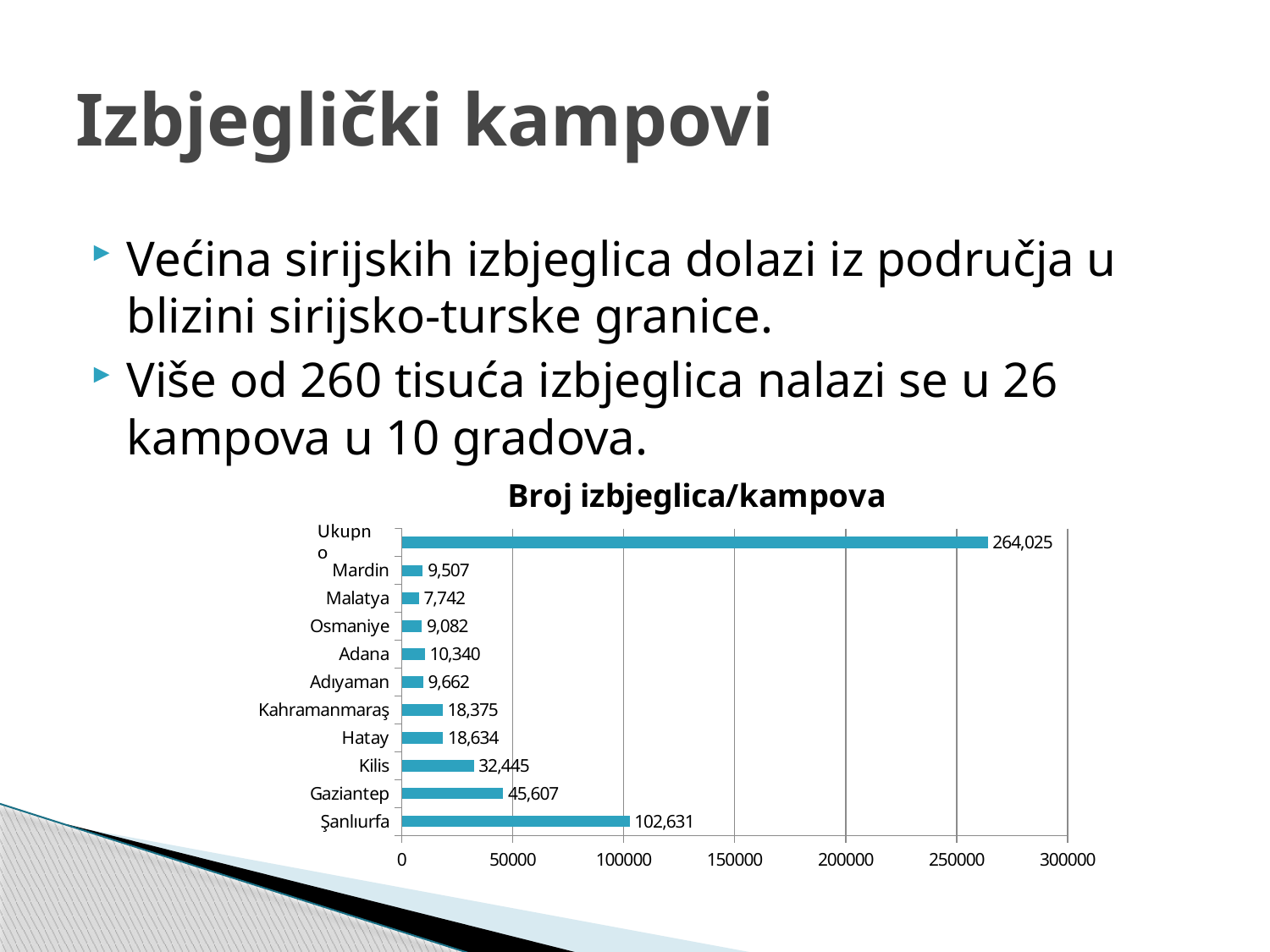
What is the value for Ukupno? 264,025 What is the title of the chart? Broj izbjeglica/kampova Which category has the lowest value? Malatya What is the difference between the values for Şanlıurfa and Gaziantep? 57,024 Excluding the Ukupno total bar, which city has the highest value? Şanlıurfa What is the value for Şanlıurfa? 102,631 What is the value for Gaziantep? 45,607 What kind of chart is shown on the slide? bar chart Which is larger, the value for Adana or the value for Osmaniye? Adana How many categories are shown on the chart? 11 Is the value for Kilis greater or less than 50000? less What is the value for Kilis? 32,445